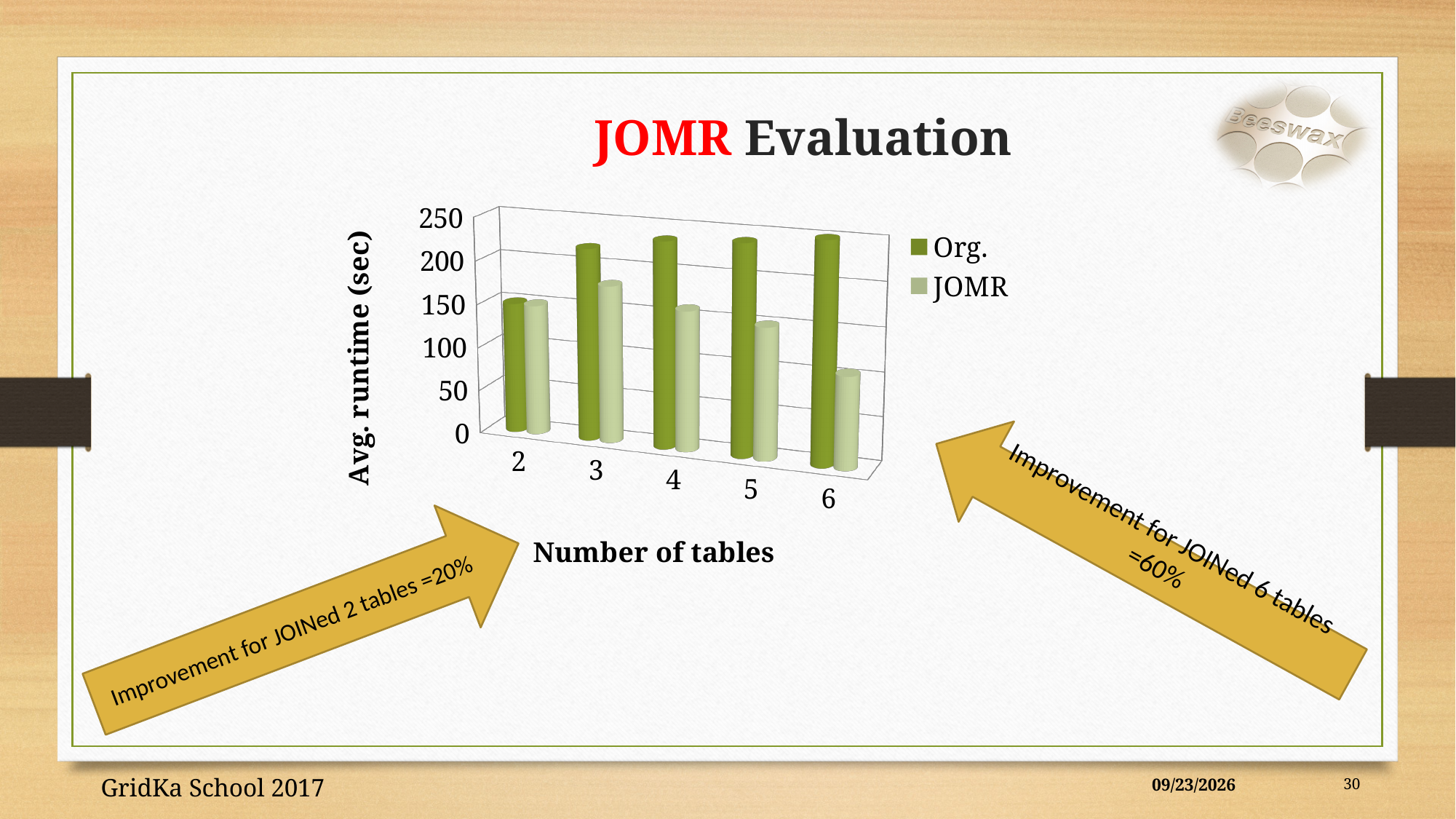
For which number of tables is the Org. runtime lowest? 2 Does the JOMR runtime rise or fall as the number of tables increases from 3 to 6? fall How many series does the chart legend list? 2 At 6 tables, which series has the larger runtime, Org. or JOMR? Org. For which number of tables is the JOMR runtime highest? 3 How many categories (numbers of tables) are plotted on the x axis? 5 What is the title of the vertical axis? Avg. runtime (sec) For which number of tables is the JOMR runtime lowest? 6 Which series are listed in the chart legend? Org. and JOMR Is the Org. value for 4 tables greater or less than 200? greater What kind of chart is shown on the slide? bar chart